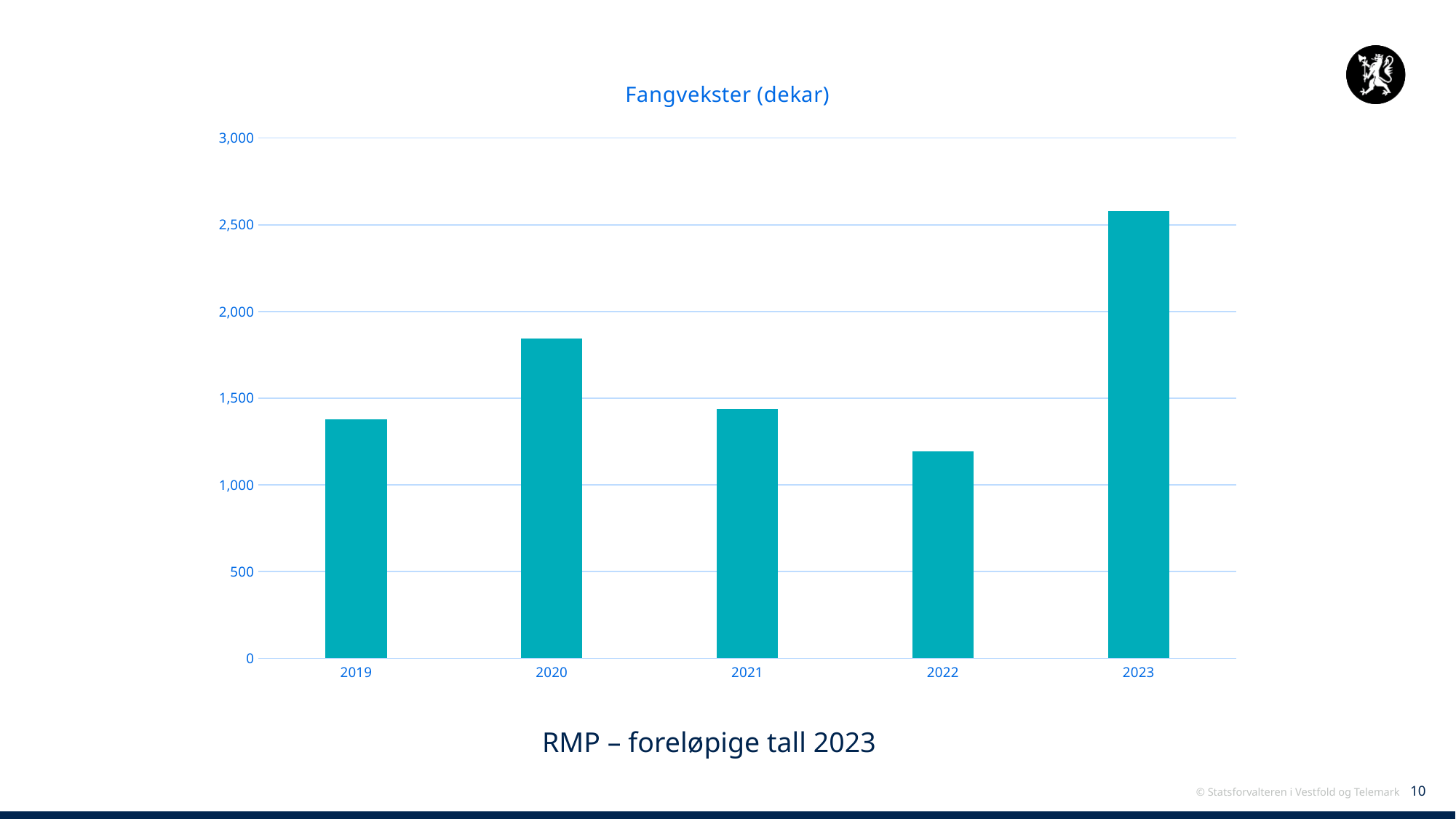
Is the value for 2022 greater or less than 1,000? greater Is the value for 2023 greater or less than 2,500? greater How many years are shown on the x axis of the chart? 5 What type of chart is shown on the slide? bar chart Which year has the larger value, 2020 or 2021? 2020 Does the value rise or fall from 2022 to 2023? rise Which year has the larger value, 2019 or 2022? 2019 What is the title of the chart? Fangvekster (dekar) Is the value for 2019 greater or less than 1,500? less Which year has the highest value in the chart? 2023 Which year has the lowest value in the chart? 2022